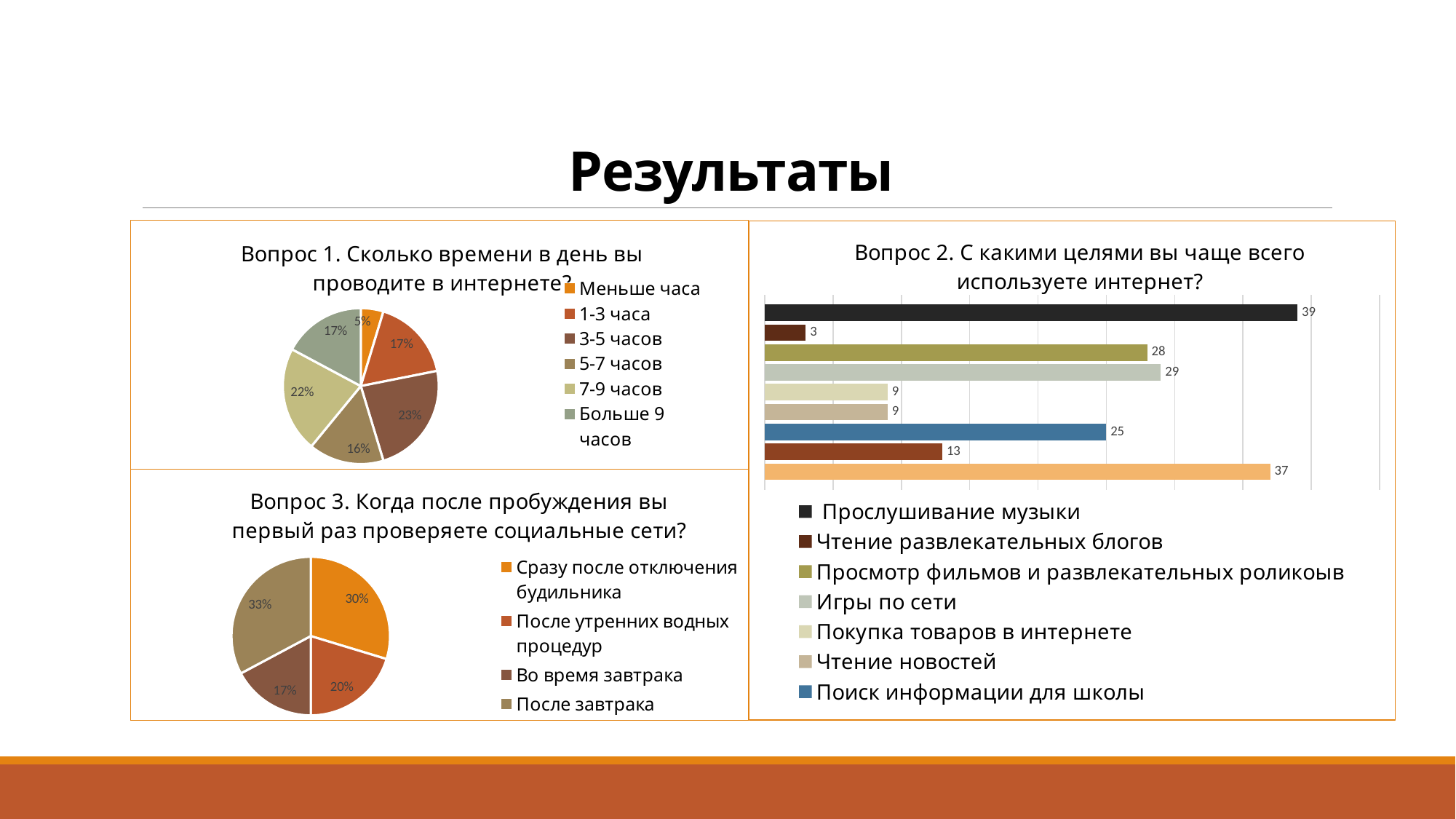
In the chart 'Вопрос 2. С какими целями вы чаще всего используете интернет?', how many bars are plotted? 9 What type of chart is used for 'Вопрос 2. С какими целями вы чаще всего используете интернет?'? Bar chart In the chart 'Вопрос 1. Сколько времени в день вы проводите в интернете?', what is the difference between the shares for '7-9 часов' and '5-7 часов'? 6% In the chart 'Вопрос 1. Сколько времени в день вы проводите в интернете?', what share is shown for '3-5 часов'? 23% In the chart 'Вопрос 2. С какими целями вы чаще всего используете интернет?', which legend category has the lowest value? Чтение развлекательных блогов In the chart 'Вопрос 1. Сколько времени в день вы проводите в интернете?', which category has the smallest share? Меньше часа In the chart 'Вопрос 2. С какими целями вы чаще всего используете интернет?', what is the value for 'Поиск информации для школы'? 25 In the chart 'Вопрос 2. С какими целями вы чаще всего используете интернет?', which is larger: 'Игры по сети' or 'Просмотр фильмов и развлекательных роликоыв'? Игры по сети In the chart 'Вопрос 3. Когда после пробуждения вы первый раз проверяете социальные сети?', what share is shown for 'Во время завтрака'? 17% In the chart 'Вопрос 2. С какими целями вы чаще всего используете интернет?', what is the value for 'Прослушивание музыки'? 39 In the chart 'Вопрос 1. Сколько времени в день вы проводите в интернете?', how many categories does the legend list? 6 In the chart 'Вопрос 3. Когда после пробуждения вы первый раз проверяете социальные сети?', which category has the largest share? После завтрака